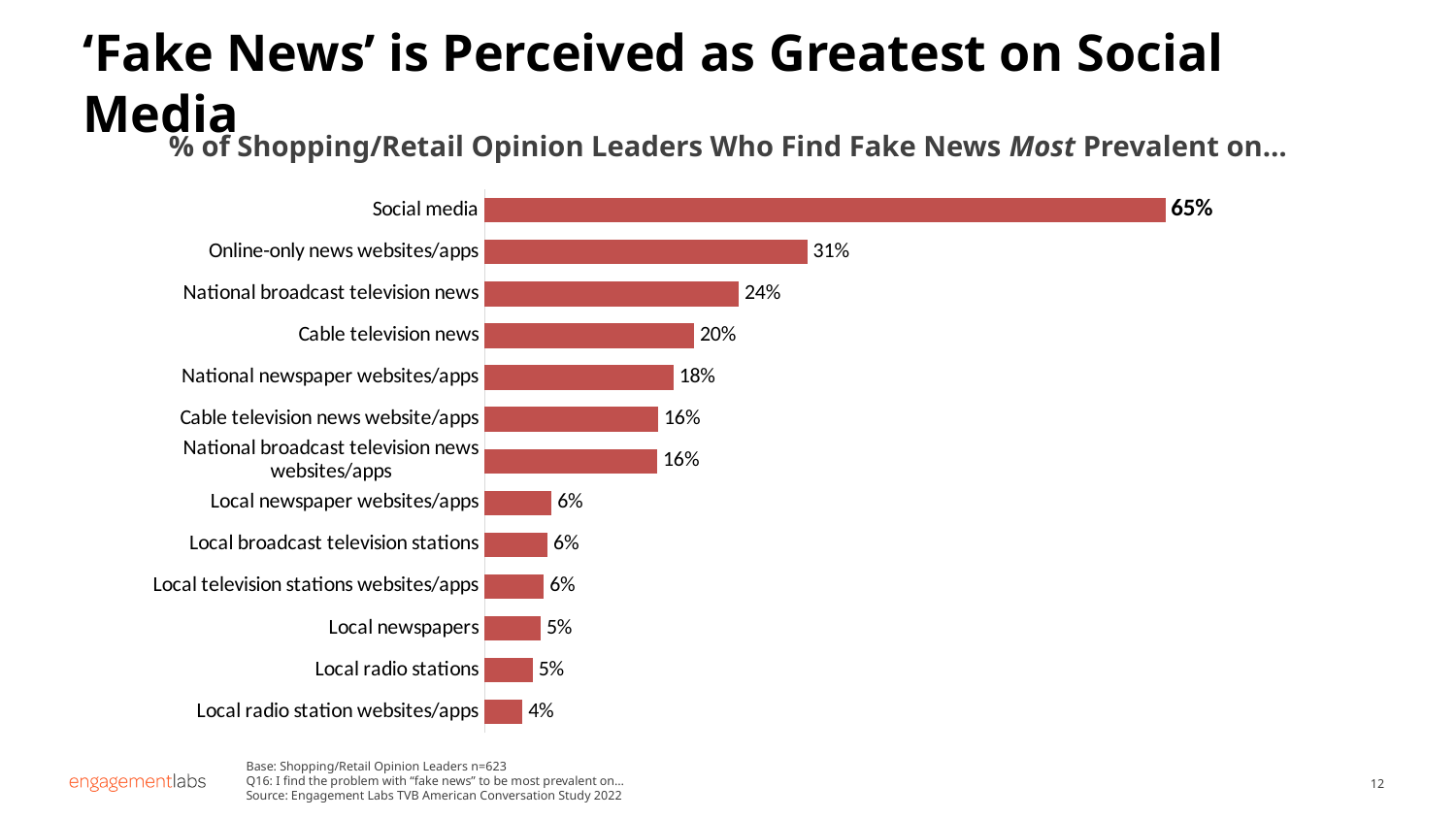
What is the base sample size noted at the bottom of the slide? n=623 What percentage of Shopping/Retail Opinion Leaders find fake news most prevalent on social media? 65% What is the value shown for Local radio station websites/apps? 4% Which is larger, the value for Cable television news or the value for Local newspapers? Cable television news How many categories are shown in the chart? 13 Which category has the lowest value in the chart? Local radio station websites/apps What is the value shown for Online-only news websites/apps? 31% What is the difference between the values for National broadcast television news and National newspaper websites/apps? 6 percentage points What type of chart is shown on the slide? Bar chart What is the value shown for Cable television news? 20% Which category has the highest value in the chart? Social media What is the difference between the values for Social media and Online-only news websites/apps? 34 percentage points